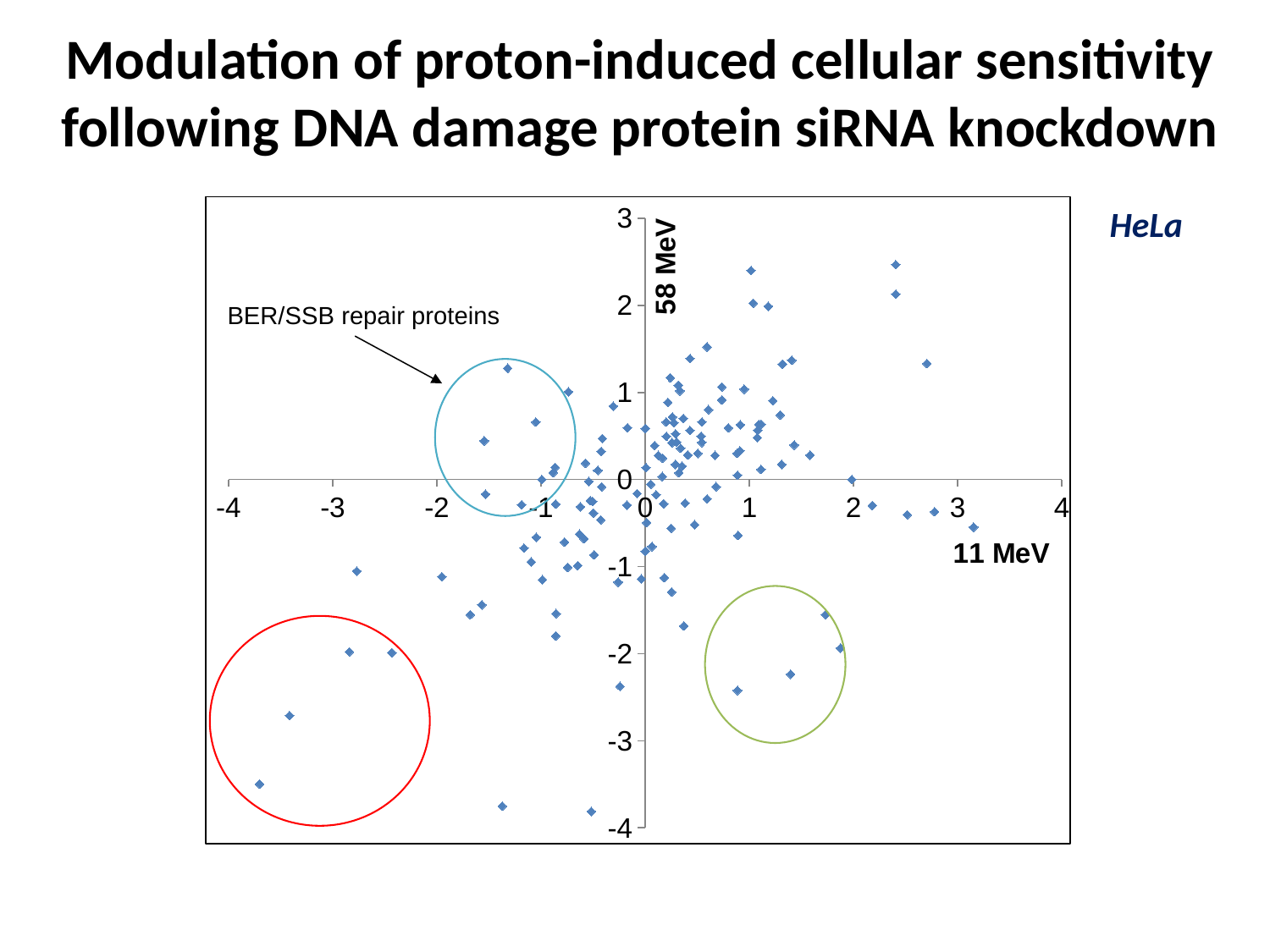
Is the smallest 11 MeV value reached by any point on the chart greater or less than -3? less What group of proteins does the arrow-labelled annotation identify in the blue circle? BER/SSB repair proteins Is the highest 58 MeV value reached by any point on the chart greater or less than 2? greater Is the largest 11 MeV value reached by any point on the chart greater or less than 3? greater What label is given to the horizontal axis of the chart? 11 MeV What kind of chart is shown on the slide? scatter plot